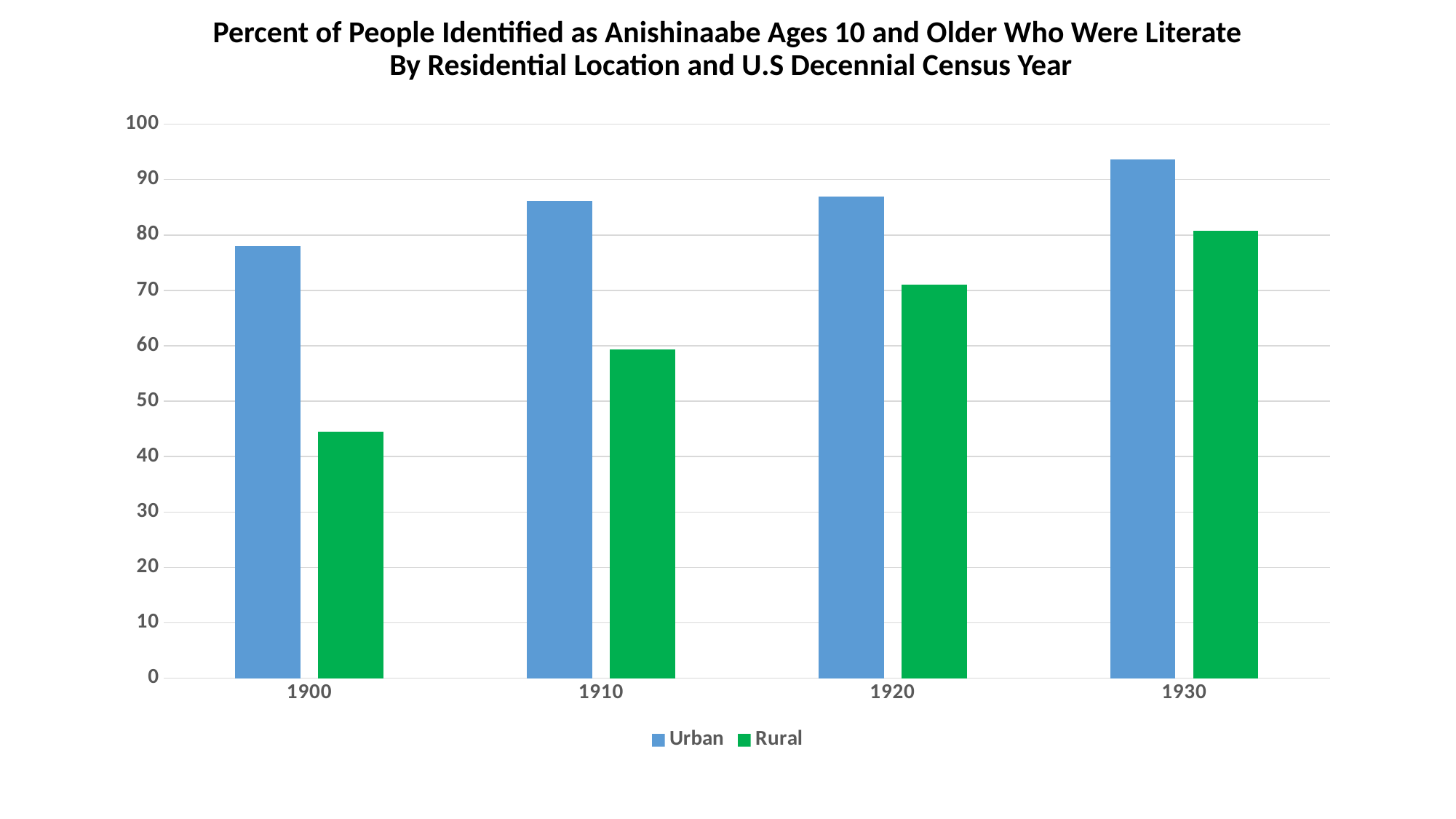
Which census year has the lowest Urban value? 1900 Is the Rural value for 1930 greater or less than 70? greater Is the Rural value for 1900 greater or less than 50? less Which census year has the highest Urban value? 1930 Is the Urban value for 1910 greater or less than 80? greater How many census years are shown on the x axis? 4 How many series does the legend list? 2 Which census year has the lowest Rural value? 1900 Which is larger in 1920, the Urban value or the Rural value? Urban What kind of chart is shown on the slide? bar chart Do the Rural values rise or fall from 1900 to 1930? rise